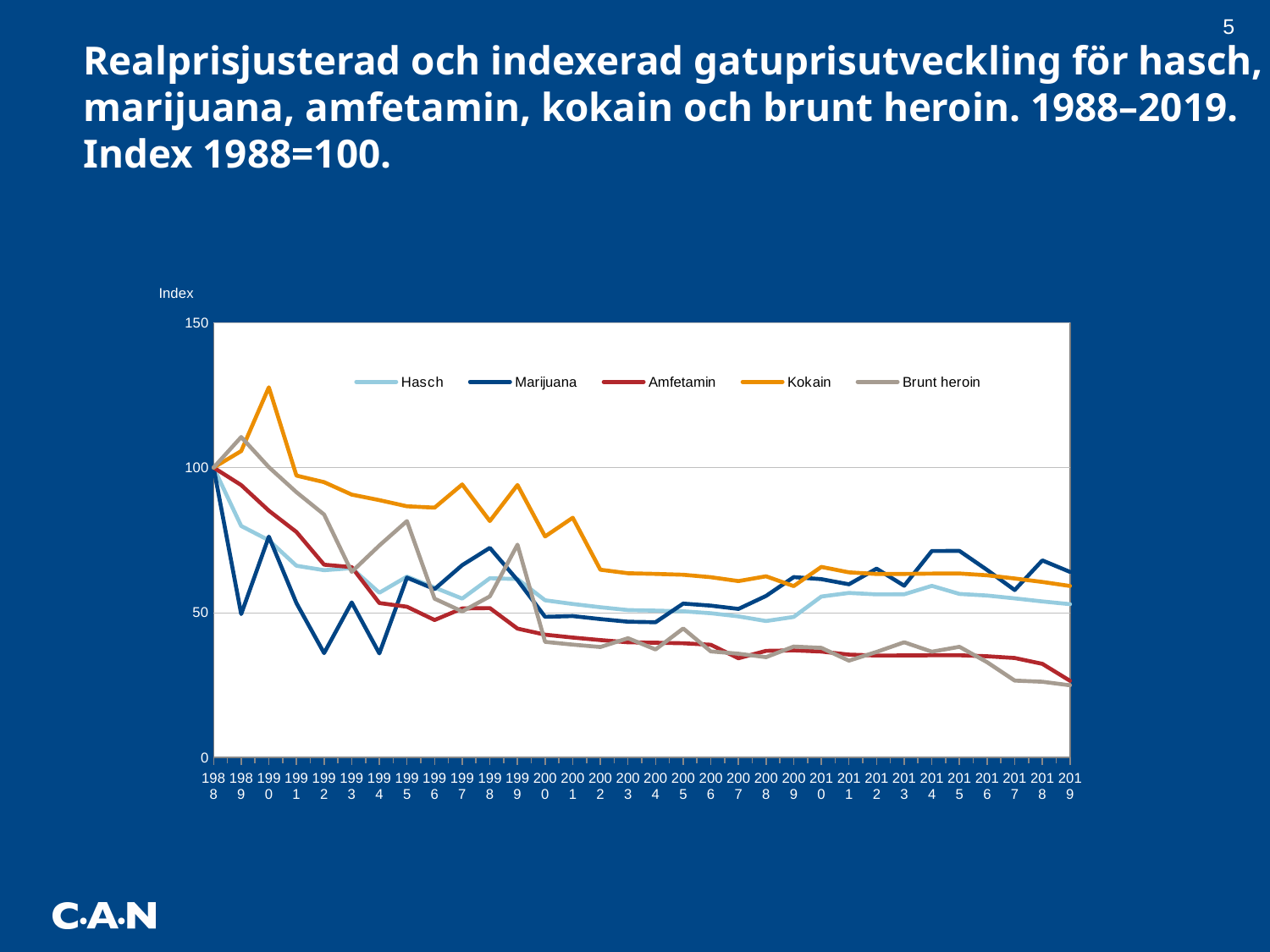
What is the index value for Kokain in 1988? 100 What kind of chart is shown on the slide? line chart Does the Amfetamin series generally rise or fall from 1988 to 2019? fall Which series has the highest value in 1990? Kokain Is the value for Amfetamin in 2019 greater or less than 50? less Is the value for Marijuana in 1992 greater or less than 50? less How many years are shown along the x axis? 32 Is the value for Kokain in 1990 greater or less than 100? greater In 2019, which is larger: the value for Kokain or the value for Amfetamin? Kokain Which series has the lowest value in 1992? Marijuana How many series does the legend list? 5 What is the label on the y axis? Index